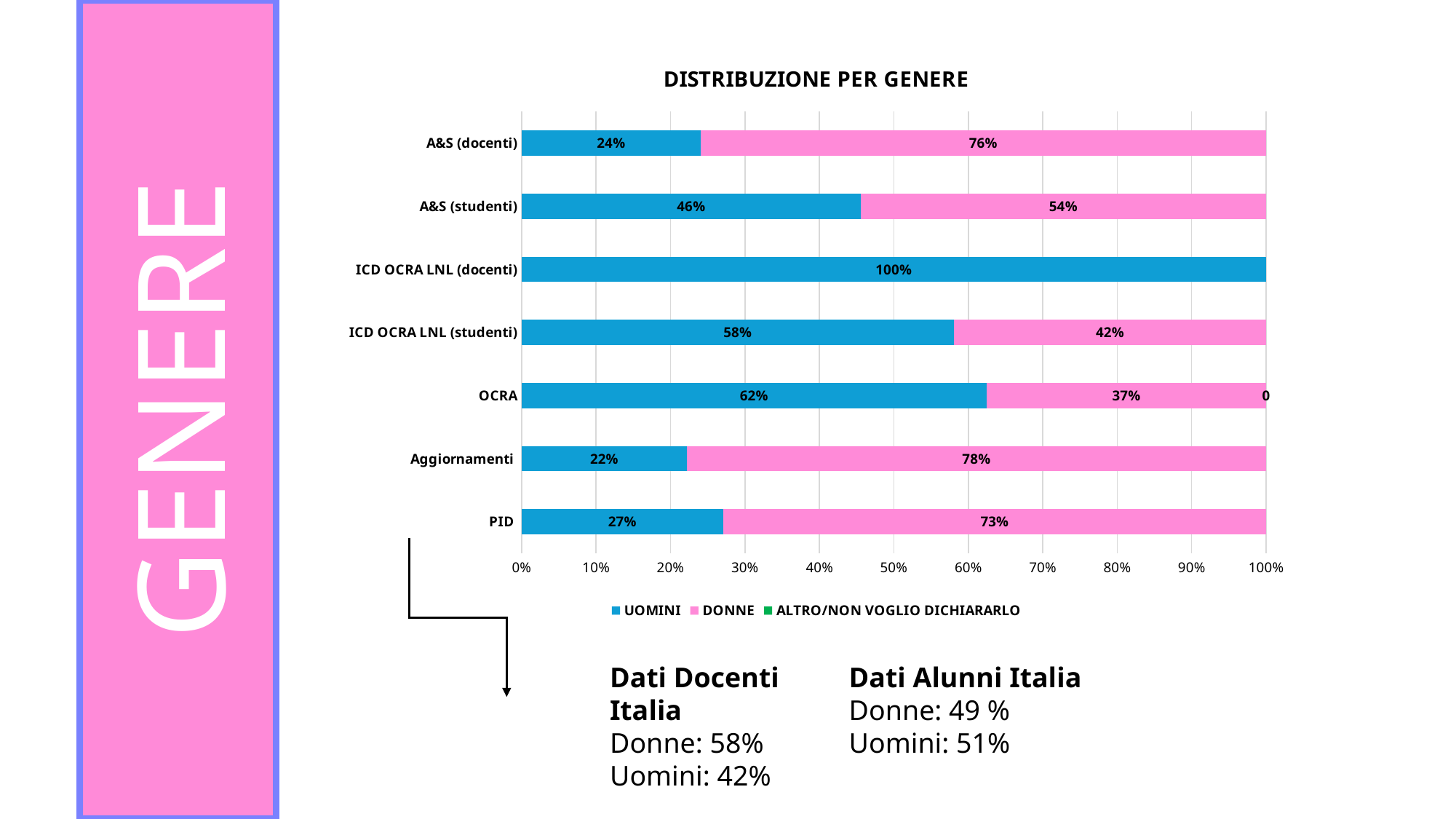
Which category has the lowest UOMINI value? Aggiornamenti What is the UOMINI value for ICD OCRA LNL (docenti)? 100% What is the DONNE value for Aggiornamenti? 78% What is the UOMINI value for A&S (docenti)? 24% What is the DONNE value for OCRA? 37% How many categories are shown on the y axis? 7 What is the difference between the DONNE values for PID and A&S (studenti)? 19% Which category has the highest UOMINI value? ICD OCRA LNL (docenti) How many series does the legend list? 3 Which is larger, the UOMINI value for OCRA or for ICD OCRA LNL (studenti)? OCRA What kind of chart is shown? Stacked bar chart What is the title of the chart? DISTRIBUZIONE PER GENERE